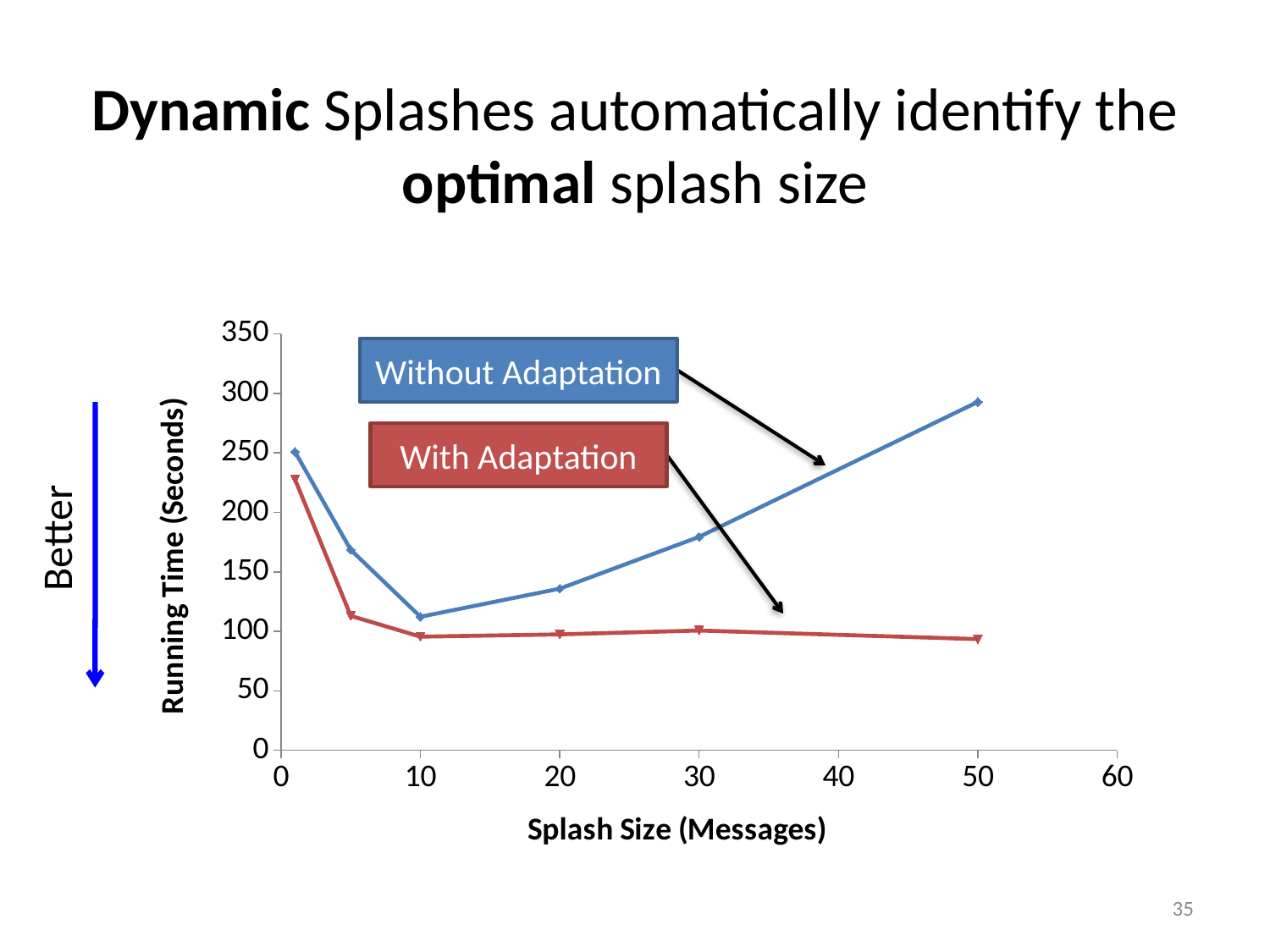
What is the title of the y axis? Running Time (Seconds) At splash size 50, which series has the higher running time, Without Adaptation or With Adaptation? Without Adaptation Is the Without Adaptation running time at splash size 30 greater or less than 150? greater At which splash size does the Without Adaptation series reach its lowest running time? 10 What kind of chart is shown on the slide? line chart How many data points does the Without Adaptation series have? 6 Is the With Adaptation running time at splash size 50 greater or less than 150? less Is the Without Adaptation running time at splash size 50 greater or less than 250? greater Does the Without Adaptation running time rise or fall as splash size increases from 10 to 50? rise What are the names of the two series plotted on the chart? Without Adaptation and With Adaptation How many series are plotted on the chart? 2 At which splash size does the Without Adaptation series reach its highest running time? 50